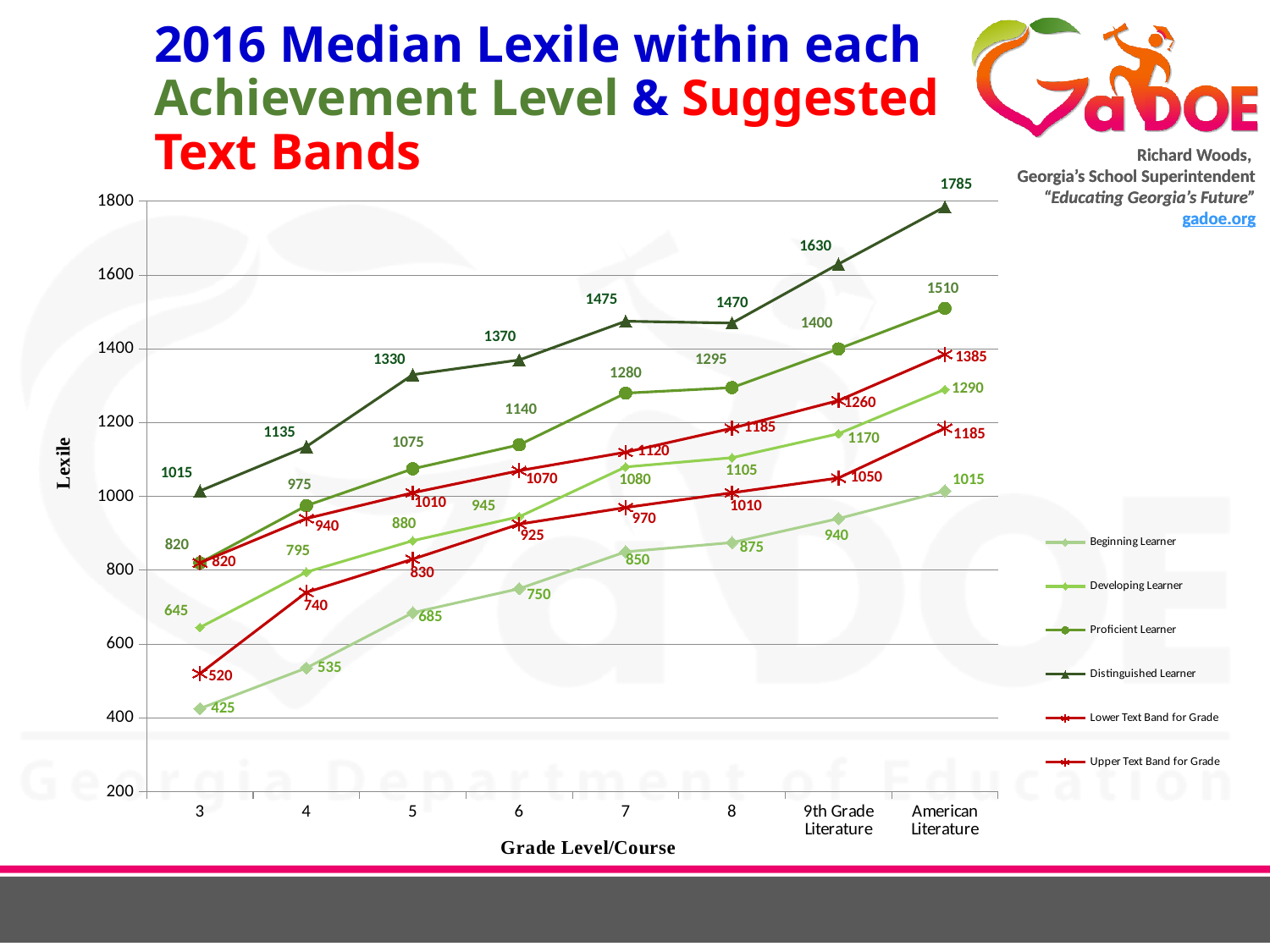
Which grade level/course has the highest Distinguished Learner median Lexile? American Literature What is the Lower Text Band for Grade value at grade 5? 830 What is the difference between the Distinguished Learner and Beginning Learner median Lexile at grade 7? 625 Which is larger at grade 6: the Developing Learner median Lexile or the Lower Text Band for Grade value? Developing Learner What kind of chart is shown on the slide? Line chart What is the Beginning Learner median Lexile for grade 3? 425 What is the Proficient Learner median Lexile for 9th Grade Literature? 1400 What is the Distinguished Learner median Lexile for American Literature? 1785 Which grade level/course has the lowest Beginning Learner median Lexile? 3 How many series does the legend list? 6 How many grade levels/courses are shown on the x axis? 8 What is the Upper Text Band for Grade value at grade 8? 1185